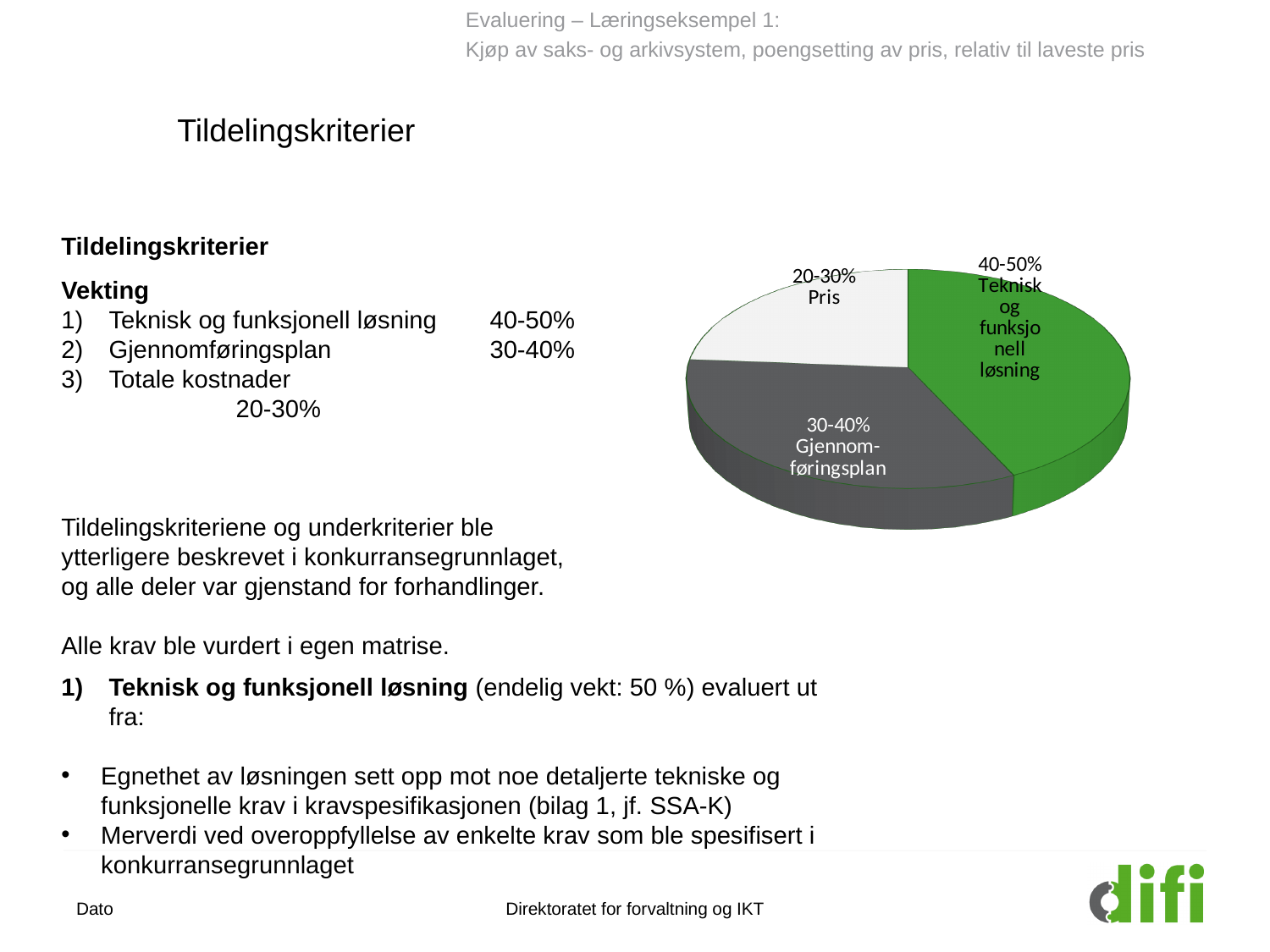
Which slice of the pie chart is the smallest? Pris What colour is the Gjennomføringsplan slice in the pie chart? dark grey How many slices does the pie chart have? 3 What weighting range is labelled on the pie chart for Teknisk og funksjonell løsning? 40-50% What weighting range is labelled on the pie chart for Gjennomføringsplan? 30-40% Which slice is larger in the pie chart, Gjennomføringsplan or Pris? Gjennomføringsplan Which slice is larger in the pie chart, Teknisk og funksjonell løsning or Gjennomføringsplan? Teknisk og funksjonell løsning What weighting range is labelled on the pie chart for Pris? 20-30% What kind of chart is shown on the slide? pie chart What colour is the Teknisk og funksjonell løsning slice in the pie chart? green Which slice of the pie chart is the largest? Teknisk og funksjonell løsning